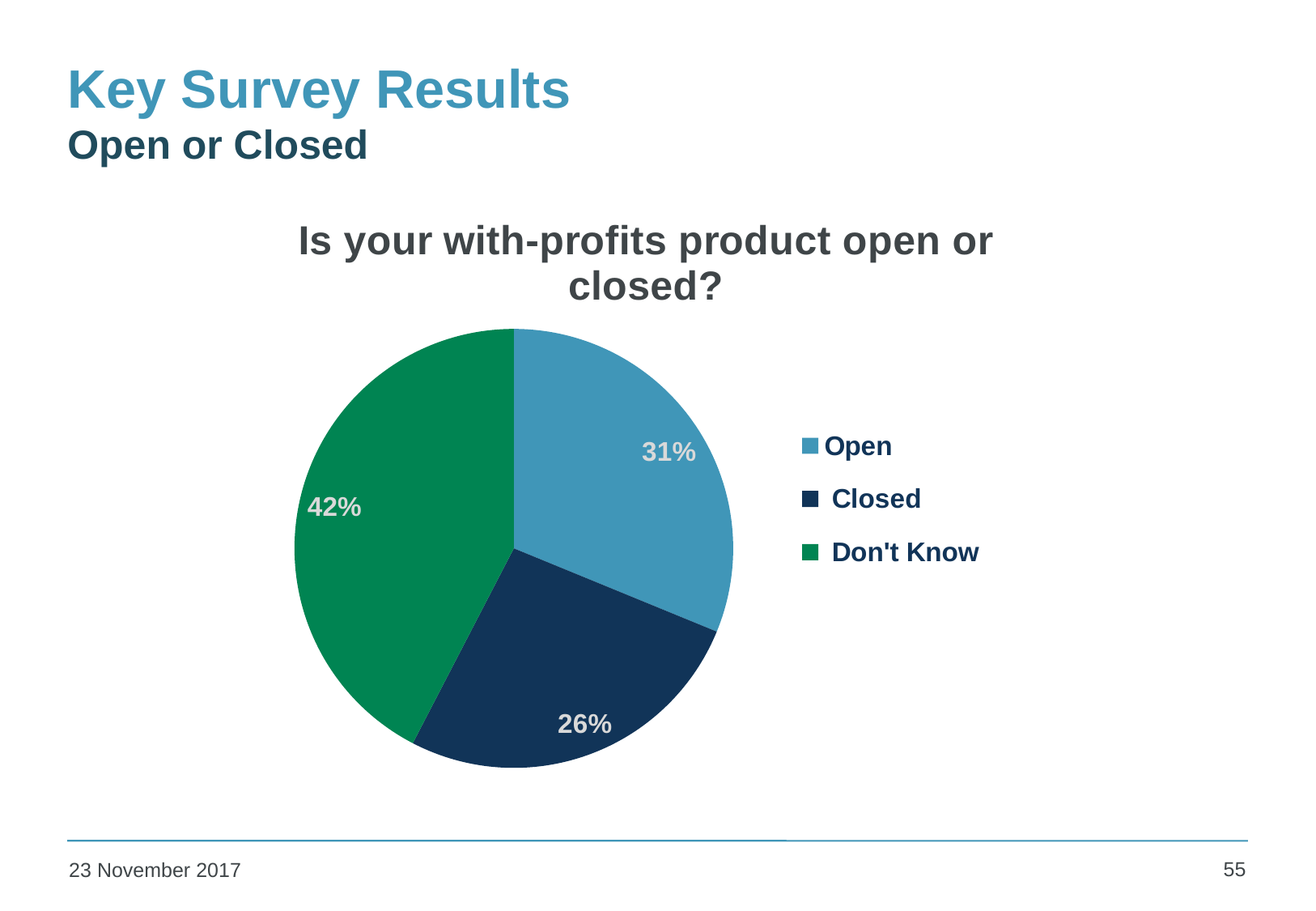
What is the difference in percentage points between 'Open' and 'Closed'? 5 What colour represents 'Don't Know' in the chart? Green What percentage of respondents answered 'Closed'? 26% What percentage of respondents answered 'Open'? 31% Which response has the largest share of the pie? Don't Know What percentage of respondents answered 'Don't Know'? 42% How many categories are shown in the pie chart? 3 What kind of chart is shown on the slide? Pie chart What is the difference in percentage points between 'Don't Know' and 'Open'? 11 Which response has the smallest share of the pie? Closed What is the title of the chart? Is your with-profits product open or closed? Which is larger, the share for 'Open' or the share for 'Closed'? Open